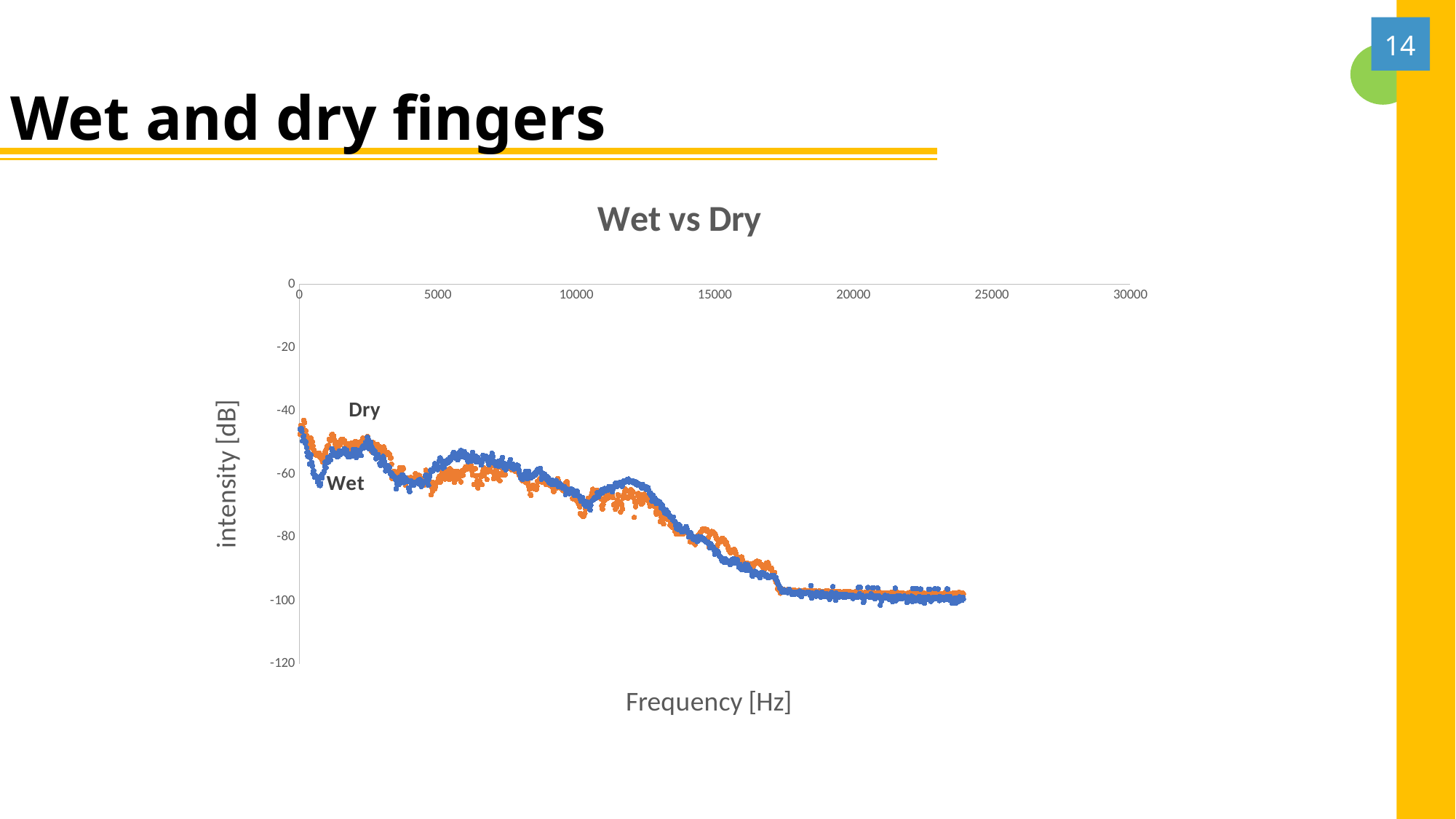
Overall, do the intensity values rise or fall as frequency increases? fall What is the title of the chart? Wet vs Dry What is the highest value shown on the x axis? 30000 How many data series are plotted in the chart? 2 Is the intensity at 5000 Hz greater or less than -80 dB? greater What is the label of the x axis? Frequency [Hz] Is the intensity at 20000 Hz greater or less than -80 dB? less Is the intensity at 22000 Hz greater or less than -60 dB? less What is the lowest value shown on the y axis? -120 What kind of chart is shown on the slide? scatter chart